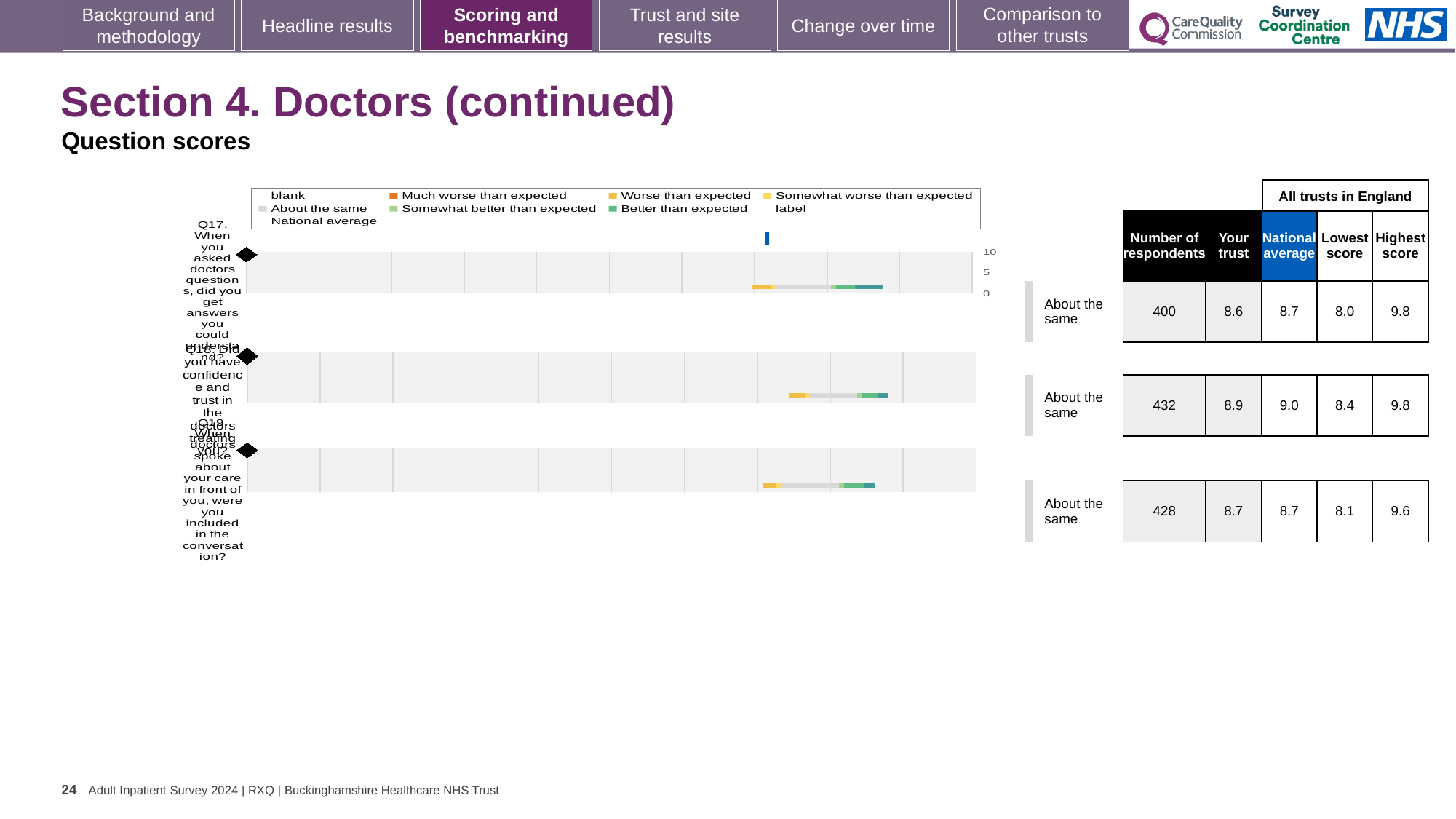
Is the 'Your trust' score for Q19 greater or less than 5 on the chart axis? greater What is the difference between the 'Your trust' scores for Q18 and Q17? 0.3 What is the national average score for Q17 (getting answers you could understand from doctors)? 8.7 What is the highest score across all trusts in England for Q19 (being included in the conversation when doctors spoke about your care)? 9.6 Which is larger: the national average for Q18 or the national average for Q17? Q18 Which question has the lowest 'Lowest score' value across all trusts in England? Q17 What is the 'Your trust' score for Q18 (confidence and trust in the doctors treating you)? 8.9 Which colour does the legend use for 'Much worse than expected'? orange Which question has the highest 'Your trust' score? Q18 What benchmark category is shown for Q17, Q18 and Q19? About the same What kind of chart is used to show the question scores for Q17, Q18 and Q19? bar chart How many questions (categories) are plotted in the chart? 3